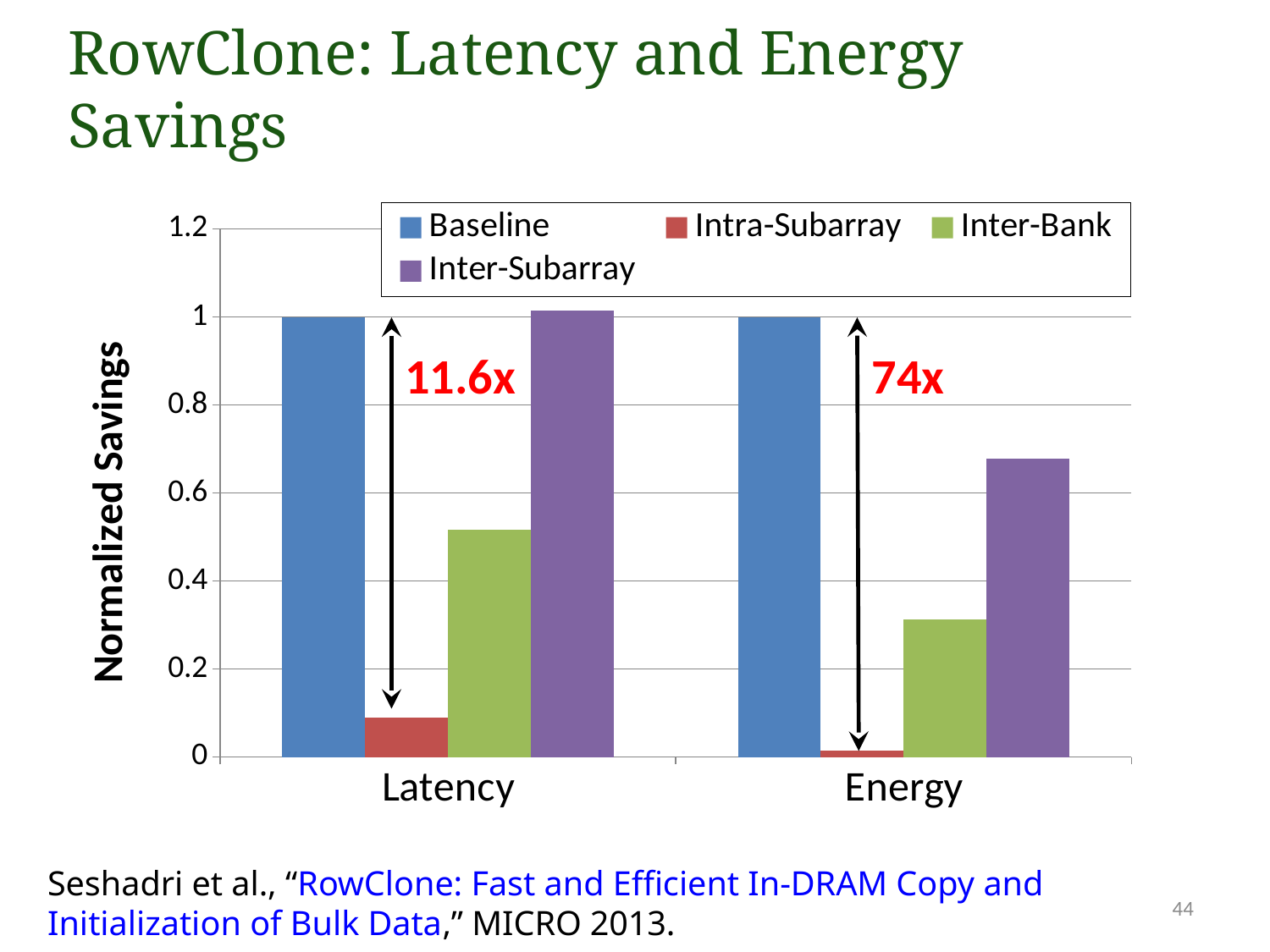
What improvement factor is annotated above the Energy bars? 74x What is the Baseline value for Energy? 1 Is the Inter-Subarray value for Energy greater or less than 0.6? greater What is the title of the y axis? Normalized Savings Which is larger, the Inter-Bank value for Latency or the Inter-Bank value for Energy? Latency How many categories are shown on the x axis? 2 Is the Inter-Bank value for Latency greater or less than 0.4? greater How many series does the legend list? 4 Which series has the lowest value for Energy? Intra-Subarray What kind of chart is shown on the slide? bar chart Is the Inter-Bank value for Energy greater or less than 0.4? less What is the Baseline value for Latency? 1